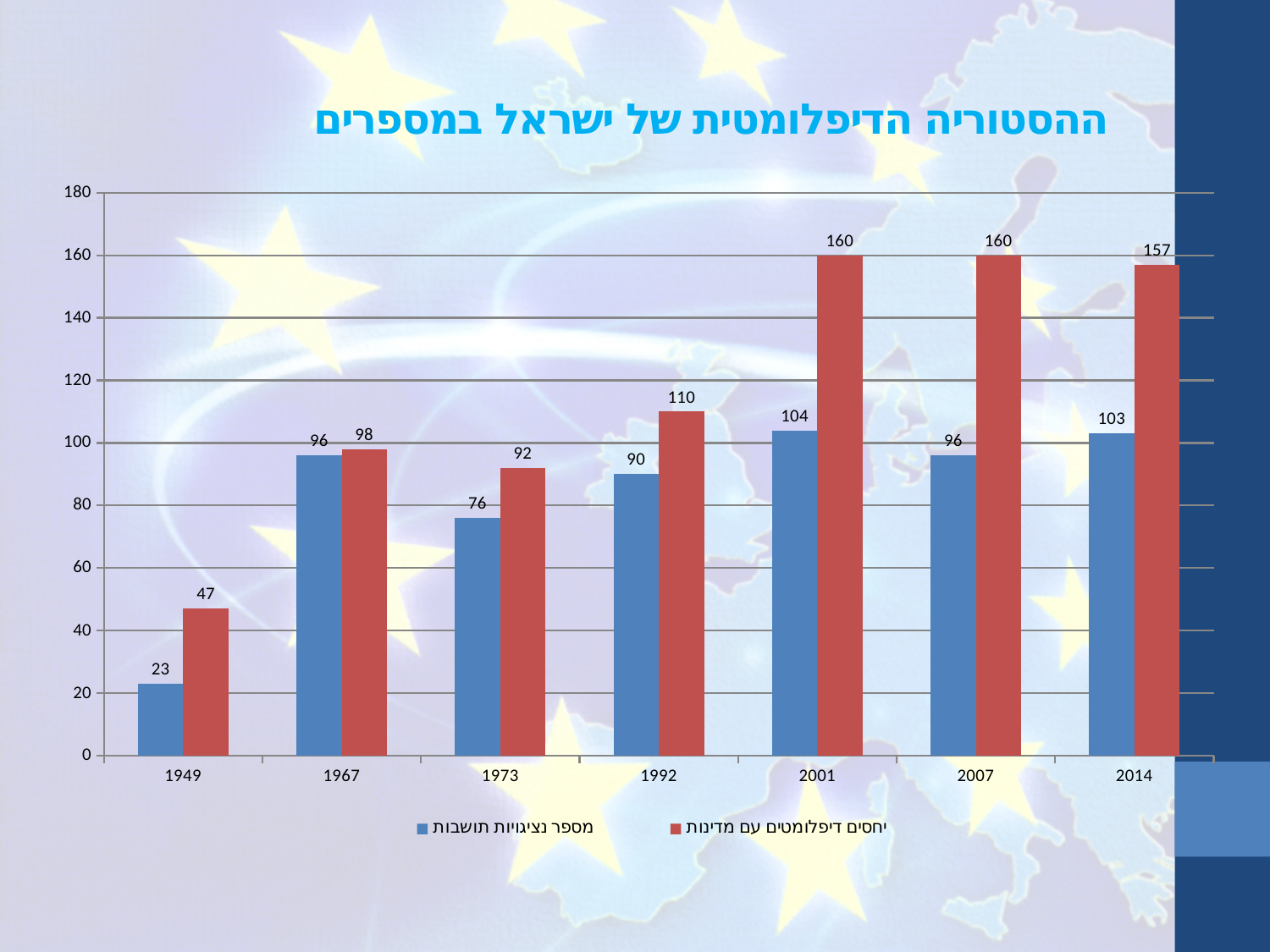
What type of chart is shown on the slide? bar chart What is the difference between the red and blue values for 2001? 56 What is the difference between the red series values for 2007 and 2014? 3 What is the value of the red series (יחסים דיפלומטים עם מדינות) for 1992? 110 What is the value of the blue series (מספר נציגויות תושבות) for 2001? 104 In which year is the blue series (מספר נציגויות תושבות) highest? 2001 What is the value of the blue series (מספר נציגויות תושבות) for 1949? 23 How many series does the legend list? 2 What is the title of the chart? ההסטוריה הדיפלומטית של ישראל במספרים In which year is the blue series (מספר נציגויות תושבות) lowest? 1949 Which is larger in 1973: the blue series value or the red series value? the red series (92) How many years are shown on the x axis? 7